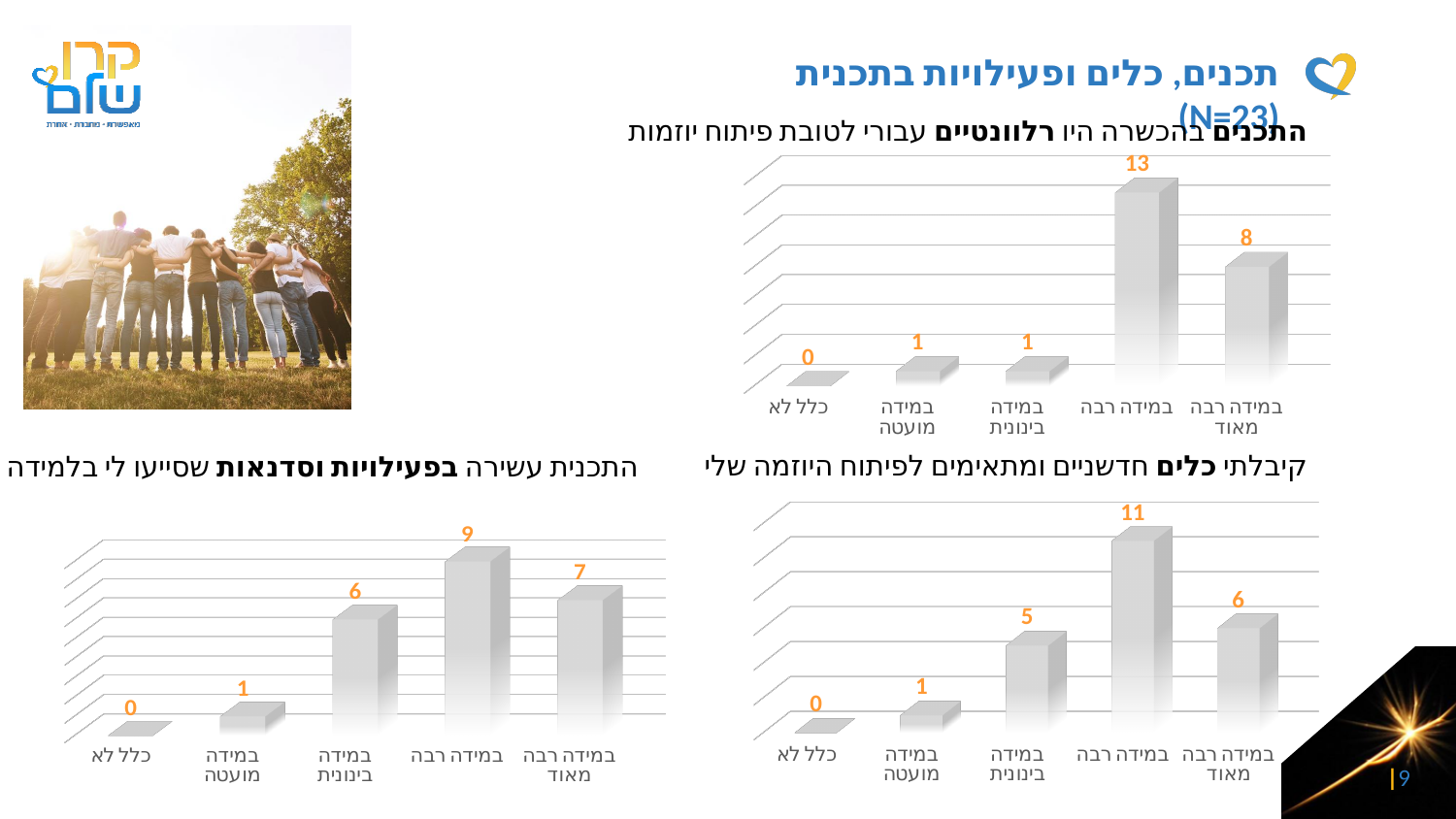
In the bottom-right chart (קיבלתי כלים חדשניים), which is larger: במידה רבה מאוד or במידה בינונית? במידה רבה מאוד In the top-right chart (התכנים בהכשרה היו רלוונטיים), what is the value for במידה רבה מאוד? 8 In the bottom-left chart (התכנית עשירה בפעילויות וסדנאות), what is the difference between במידה רבה and במידה בינונית? 3 In the bottom-left chart (התכנית עשירה בפעילויות וסדנאות שסייעו לי בלמידה), what is the value for במידה רבה? 9 In the bottom-left chart (התכנית עשירה בפעילויות וסדנאות), which category has the lowest value? כלל לא In the top-right chart (התכנים בהכשרה היו רלוונטיים), what is the difference between במידה רבה and במידה רבה מאוד? 5 In the top-right chart (התכנים בהכשרה היו רלוונטיים), which category has the highest value? במידה רבה In the top-right chart (התכנים בהכשרה היו רלוונטיים עבורי לטובת פיתוח יוזמות), what is the value for במידה רבה? 13 In the bottom-right chart (קיבלתי כלים חדשניים ומתאימים לפיתוח היוזמה שלי), what is the value for במידה בינונית? 5 What type of chart is the top-right chart (התכנים בהכשרה היו רלוונטיים)? Bar chart In the bottom-right chart (קיבלתי כלים חדשניים), which category has the highest value? במידה רבה How many categories are shown in the bottom-left chart (התכנית עשירה בפעילויות וסדנאות)? 5